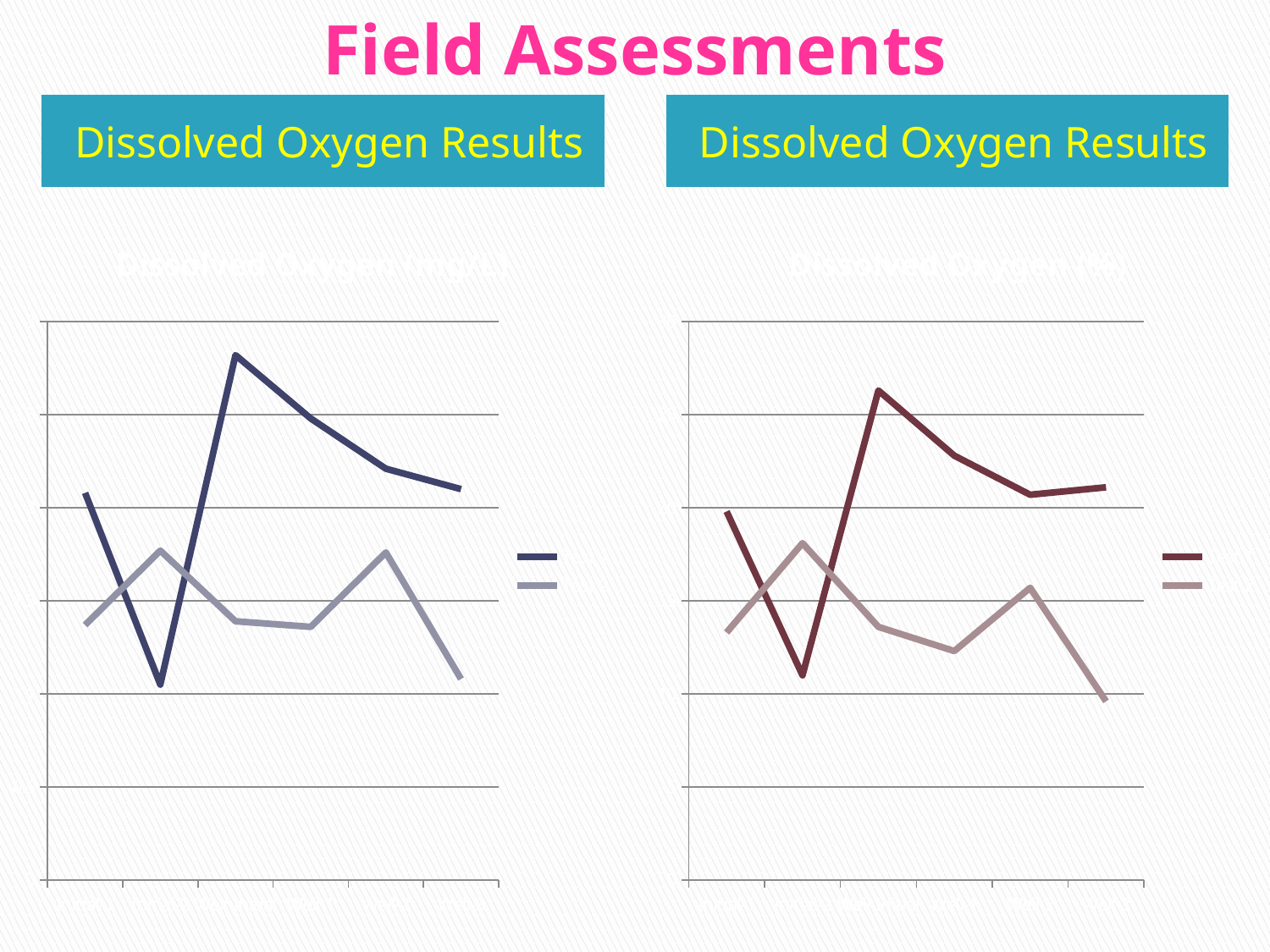
In the right chart, does the dark red line rise or fall between its second and third points? rise In the right chart, which line reaches the highest point, the dark red line or the light pink line? the dark red line In the left chart, does the dark blue line rise or fall between its first and second points? fall How many charts are shown on the slide? 2 What heading appears above each of the two charts? Dissolved Oxygen Results What kind of chart is the right chart on the slide? line chart What kind of chart is the left chart on the slide? line chart How many series does the legend of the left chart list? 2 How many data points does each line in the right chart have? 6 How many series does the legend of the right chart list? 2 How many data points does each line in the left chart have? 6 In the left chart, which line reaches the highest point, the dark blue line or the light grey line? the dark blue line